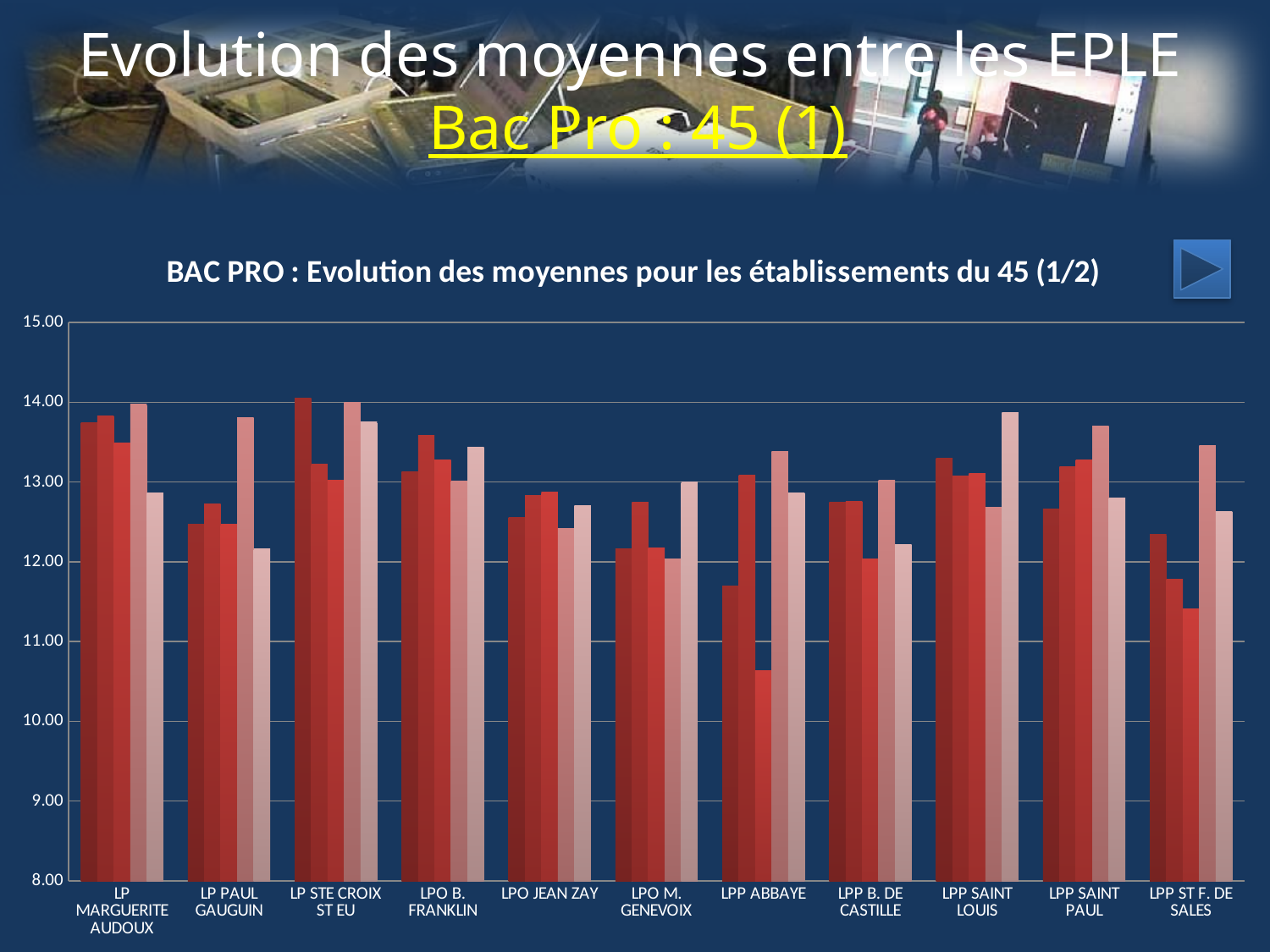
What is the title of the chart? BAC PRO : Evolution des moyennes pour les établissements du 45 (1/2) Are all the bars for LP PAUL GAUGUIN greater or less than 14.00? less What is the maximum value shown on the vertical axis of the chart? 15.00 Is the rightmost bar for LPP SAINT LOUIS greater or less than 13.50? greater Is the leftmost bar for LP MARGUERITE AUDOUX greater or less than 13.00? greater What kind of chart is shown on the slide? bar chart Which establishment contains the lowest bar on the chart? LPP ABBAYE How many establishments (categories) are shown on the x axis of the chart? 11 How many bars are plotted for each establishment in the chart? 5